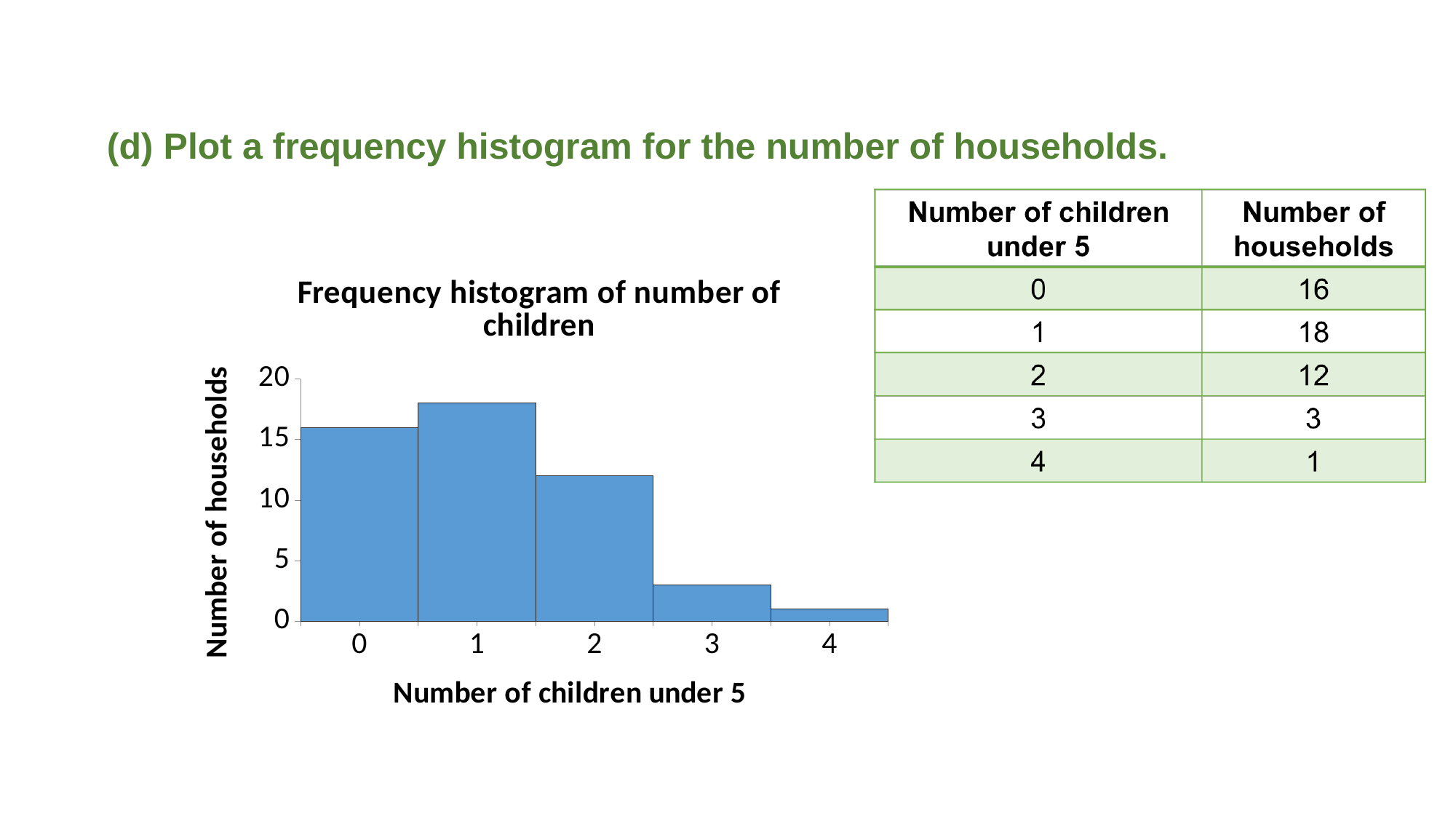
How many bars does the histogram have? 5 What is the difference between the number of households with 1 child under 5 and with 2 children under 5? 6 What is the title of the chart? Frequency histogram of number of children How many households have 0 children under 5? 16 What kind of chart is shown on the slide? bar chart (histogram) How many households have 2 children under 5? 12 Which number of children under 5 has the lowest number of households? 4 How many households have 1 child under 5? 18 Is the number of households with 3 children under 5 greater or less than 5? less Is the number of households with 0 children under 5 greater or less than 15? greater Which has more households: 0 children under 5 or 2 children under 5? 0 children under 5 Which number of children under 5 has the highest number of households? 1